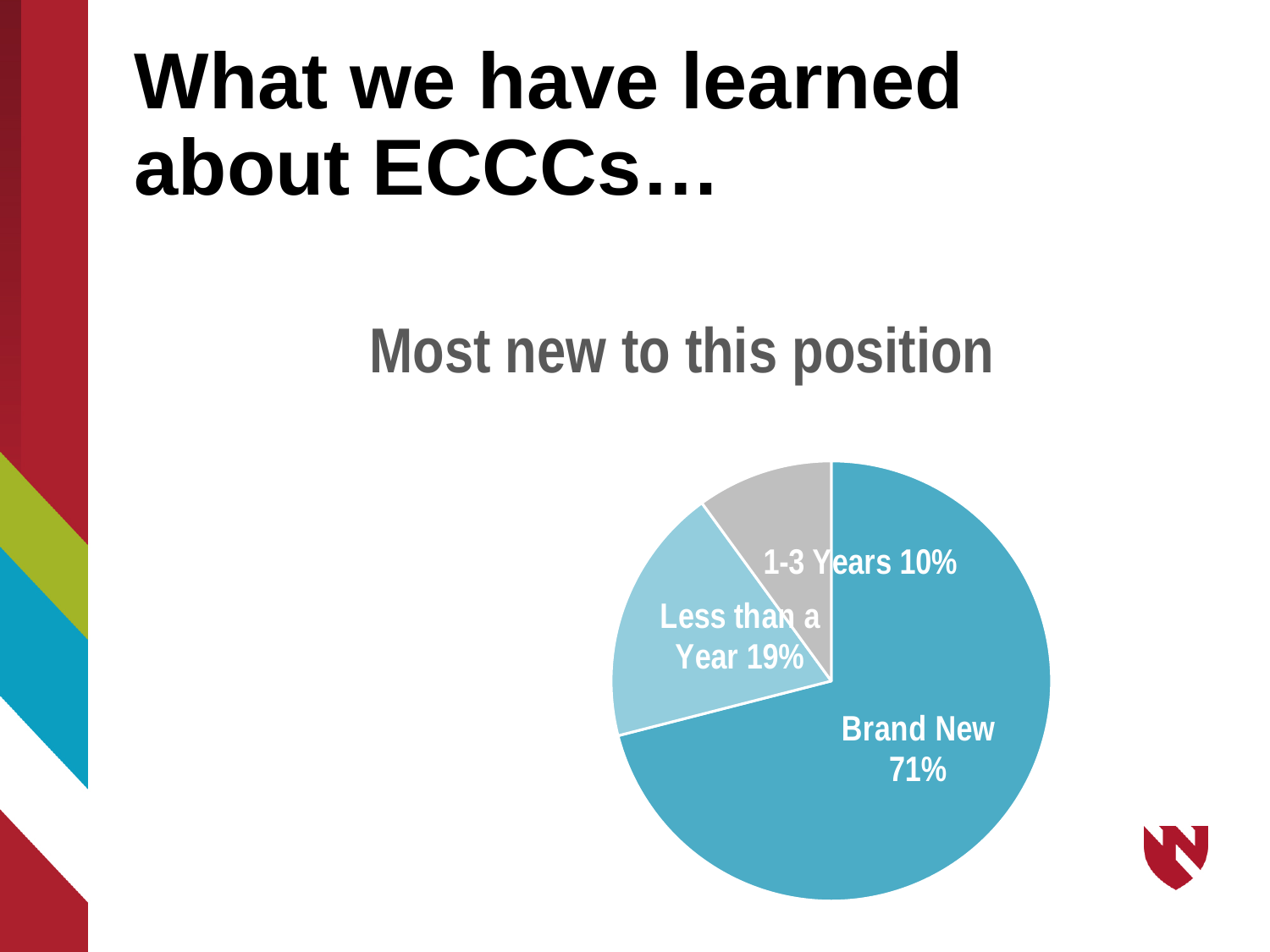
What kind of chart is shown on the slide? pie chart Which is larger, the Less than a Year slice or the 1-3 Years slice? Less than a Year How many slices does the pie chart have? 3 What share of the pie is labelled Brand New? 71% What share of the pie is labelled Less than a Year? 19% What is the heading shown above the pie chart? Most new to this position What share of the pie is labelled 1-3 Years? 10% Which slice of the pie is the smallest? 1-3 Years What is the difference in percentage points between the Brand New slice and the Less than a Year slice? 52 What is the difference in percentage points between the Less than a Year slice and the 1-3 Years slice? 9 What is the combined share of the Less than a Year and 1-3 Years slices? 29% Which slice of the pie is the largest? Brand New